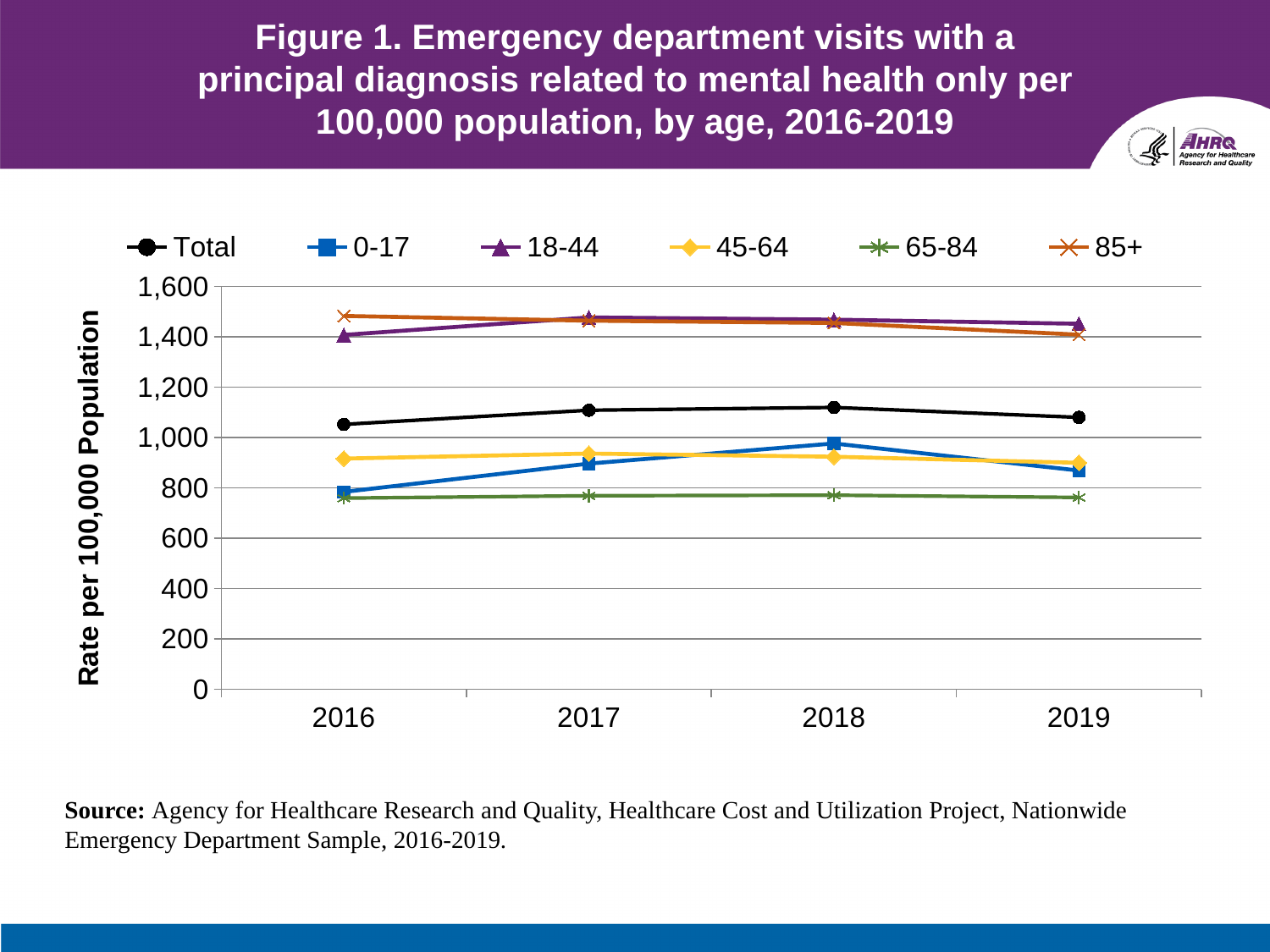
What is the title of the y axis? Rate per 100,000 Population Is the value for 0-17 in 2016 greater or less than 1,000? less How many years are plotted along the x axis? 4 Does the rate for 0-17 rise or fall from 2016 to 2018? rise Which age group has the lowest rate in 2019? 65-84 Is the value for 85+ in 2016 greater or less than 1,400? greater In 2019, which is larger: the rate for 18-44 or the rate for 85+? 18-44 Does the rate for 85+ rise or fall from 2016 to 2019? fall In 2016, which is larger: the rate for 85+ or the rate for 18-44? 85+ What kind of chart is shown on the slide? line chart How many series does the legend list? 6 Is the value for Total in 2016 greater or less than 1,000? greater